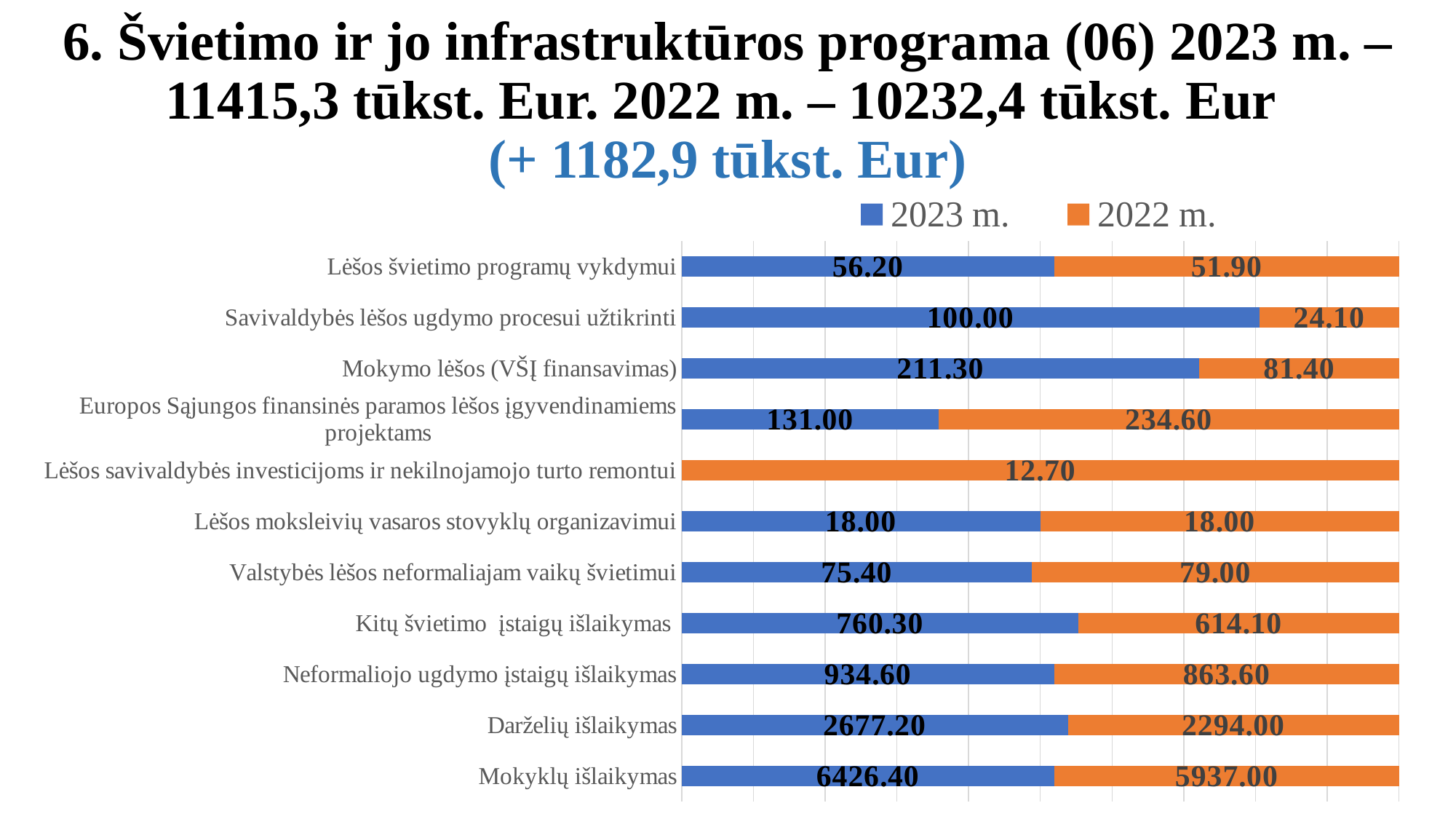
Which category has the highest 2023 m. value? Mokyklų išlaikymas What is the 2023 m. value for Mokymo lėšos (VŠĮ finansavimas)? 211.30 What is the 2022 m. value for Darželių išlaikymas? 2294.00 What kind of chart is shown on the slide? Bar chart How many series does the legend list? 2 How many categories are shown in the chart? 11 For Europos Sąjungos finansinės paramos lėšos įgyvendinamiems projektams, which year has the larger value, 2023 m. or 2022 m.? 2022 m. For Kitų švietimo įstaigų išlaikymas, which year has the larger value, 2023 m. or 2022 m.? 2023 m. What is the 2022 m. value for Lėšos savivaldybės investicijoms ir nekilnojamojo turto remontui? 12.70 What is the difference between the 2023 m. and 2022 m. values for Mokyklų išlaikymas? 489.40 What is the 2023 m. value for Mokyklų išlaikymas? 6426.40 Which category has the lowest 2022 m. value? Lėšos savivaldybės investicijoms ir nekilnojamojo turto remontui